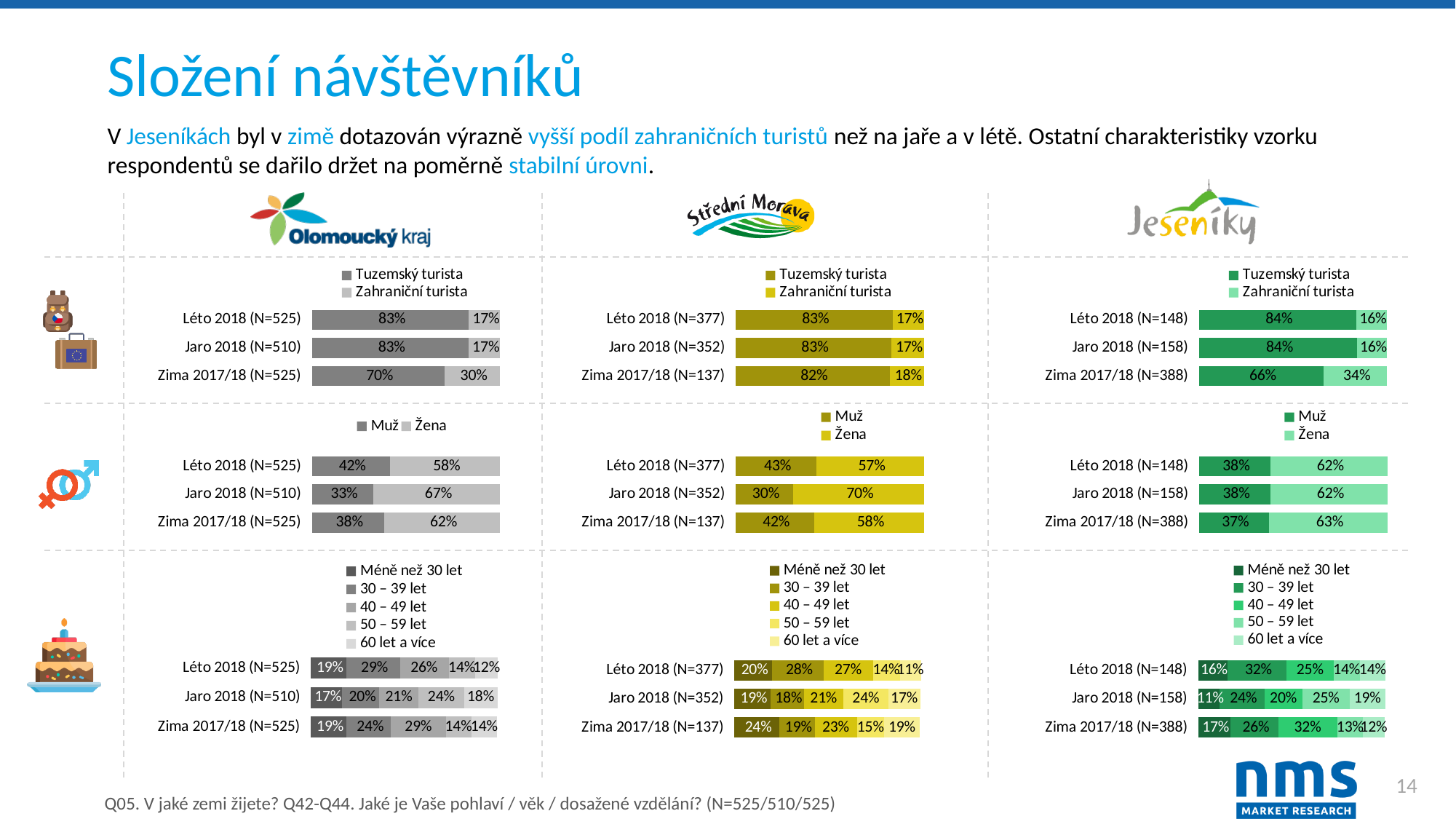
In the Střední Morava age chart, which age group has the highest share in Jaro 2018 (N=352)? 50 – 59 let In the Olomoucký kraj gender chart, what is the difference between Žena and Muž in Jaro 2018 (N=510)? 34 percentage points What kind of chart is used for the Jeseníky tourist-origin data? Stacked bar chart In the Jeseníky age chart, what is the value for 40 – 49 let in Zima 2017/18 (N=388)? 32% In the Olomoucký kraj age chart, what is the value for 50 – 59 let in Jaro 2018 (N=510)? 24% In the Střední Morava gender chart (Muž/Žena), what is the value for Muž in Jaro 2018 (N=352)? 30% How many series does the legend of the Olomoucký kraj age chart list? 5 In the Jeseníky tourist-origin chart (Tuzemský/Zahraniční turista), what is the value for Zahraniční turista in Zima 2017/18 (N=388)? 34% In the Jeseníky tourist-origin chart, is the Zahraniční turista share larger in Zima 2017/18 or in Léto 2018? Zima 2017/18 In the Střední Morava age chart, what is the value for Méně než 30 let in Zima 2017/18 (N=137)? 24% In the Jeseníky gender chart, what is the value for Žena in Zima 2017/18 (N=388)? 63% In the Olomoucký kraj tourist-origin chart, what share of Tuzemský turista is shown for Zima 2017/18 (N=525)? 70%